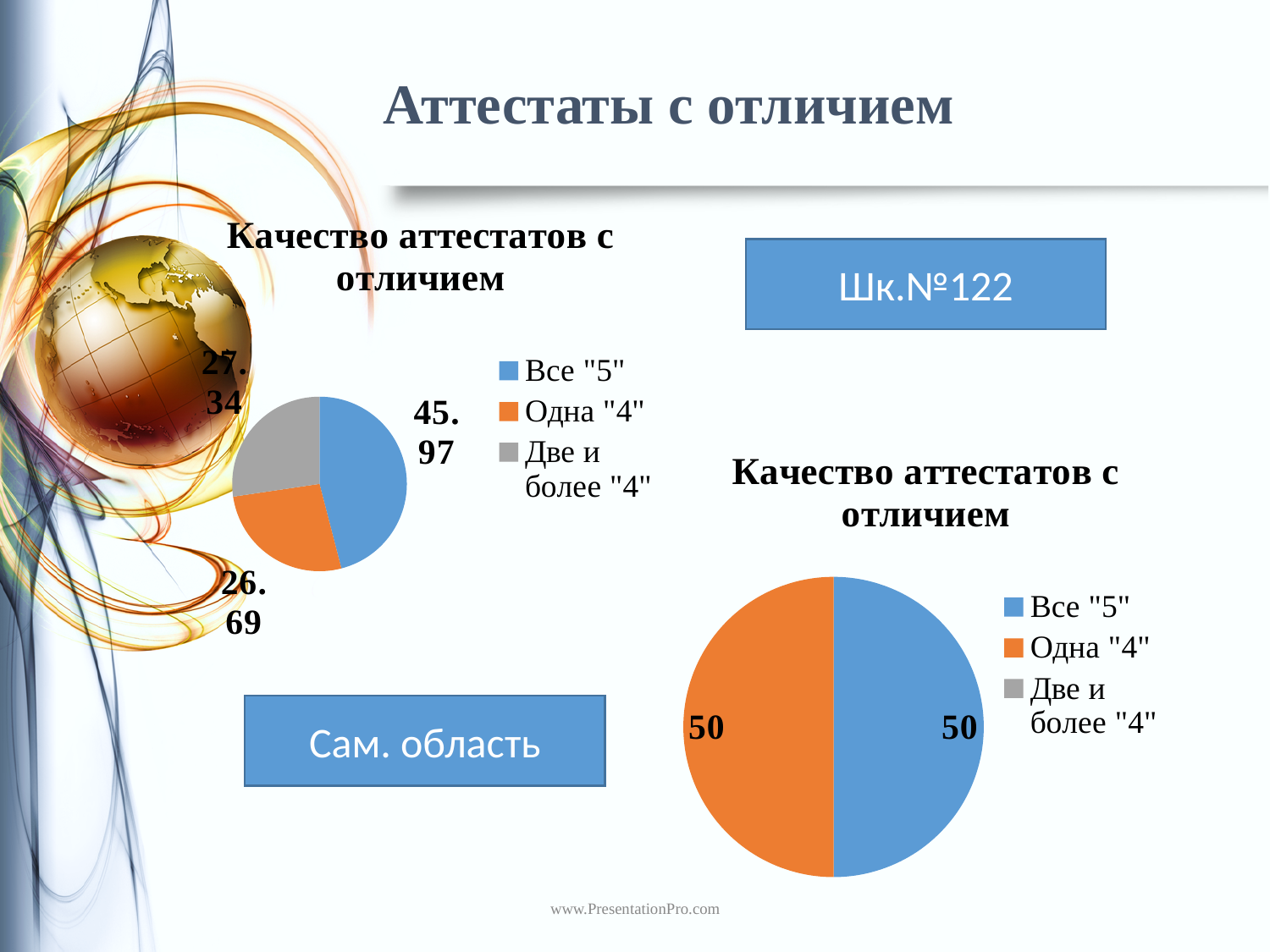
How many entries does the legend of the right chart (Шк.№122) list? 3 Which is larger: the value for Все "5" in the left chart (Сам. область) or in the right chart (Шк.№122)? right chart (Шк.№122) In the left chart (Сам. область), what is the difference between the values for Все "5" and Одна "4"? 19.28 In the left chart (Сам. область), what is the value for Одна "4"? 26.69 In the right chart (Шк.№122), what is the value for Все "5"? 50 What kind of chart is the left chart (Сам. область)? pie chart In the left chart (Сам. область), which category has the largest slice? Все "5" In the left chart (Сам. область), what is the value for Все "5"? 45.97 How many slices are visible in the right chart (Шк.№122)? 2 In the right chart (Шк.№122), what is the value for Одна "4"? 50 In the left chart (Сам. область), what is the value for Две и более "4"? 27.34 In the left chart (Сам. область), which category has the smallest value? Одна "4"